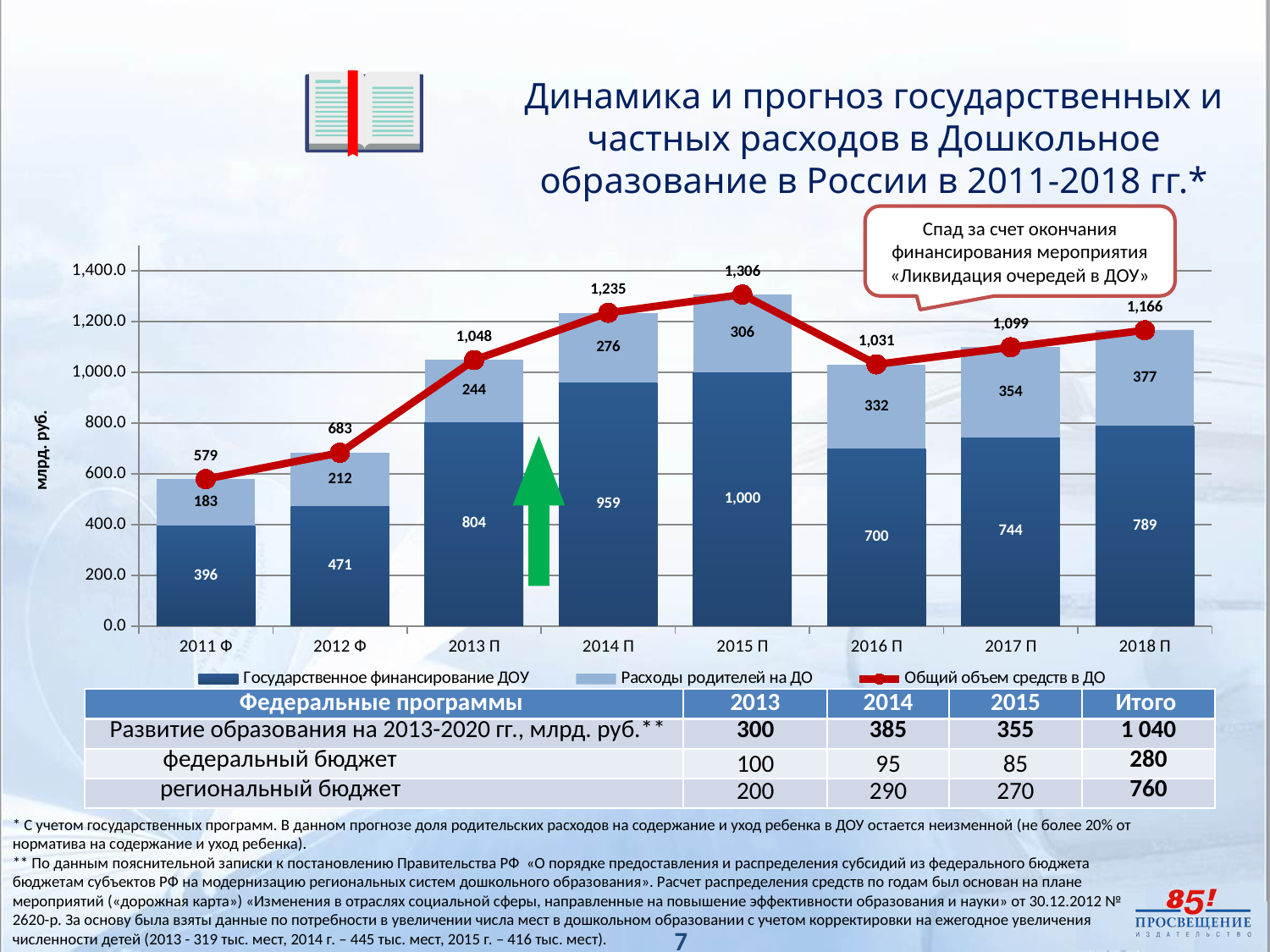
What is the unit shown on the y axis of the chart? млрд. руб. How many years are shown on the x axis of the chart? 8 In which year is Государственное финансирование ДОУ the lowest? 2011 Ф What is the value of Общий объем средств в ДО for 2013 П? 1,048 Which is larger: Расходы родителей на ДО in 2016 П or in 2014 П? 2016 П What is the difference between Общий объем средств в ДО in 2015 П and 2016 П? 275 What type of chart is used to show Государственное финансирование ДОУ and Расходы родителей на ДО? Stacked bar chart How many series does the chart legend list? 3 In which year is Общий объем средств в ДО the highest? 2015 П What is the value of Расходы родителей на ДО for 2018 П? 377 What is the value of Государственное финансирование ДОУ for 2015 П? 1,000 Is the value of Государственное финансирование ДОУ for 2017 П greater or less than 800.0? less